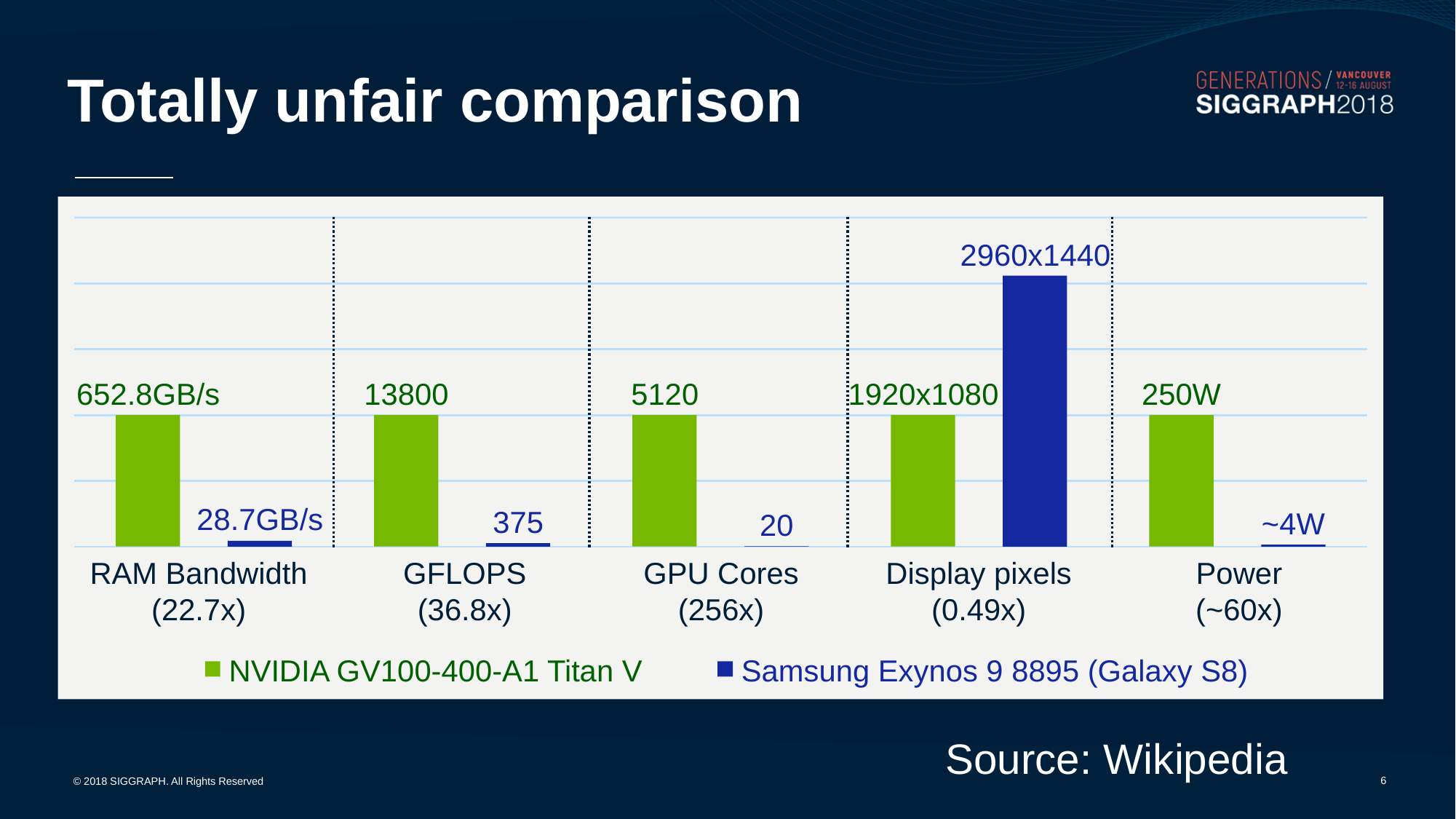
What is the RAM Bandwidth value for the NVIDIA GV100-400-A1 Titan V? 652.8GB/s For Display pixels, which series has the taller bar? Samsung Exynos 9 8895 (Galaxy S8) How many series does the legend list? 2 What is the difference in GPU Cores between the NVIDIA GV100-400-A1 Titan V and the Samsung Exynos 9 8895 (Galaxy S8)? 5100 What is the difference in GFLOPS between the NVIDIA GV100-400-A1 Titan V and the Samsung Exynos 9 8895 (Galaxy S8)? 13425 What is the Power value for the NVIDIA GV100-400-A1 Titan V? 250W How many GPU Cores does the Samsung Exynos 9 8895 (Galaxy S8) have according to the chart? 20 What is the RAM Bandwidth value for the Samsung Exynos 9 8895 (Galaxy S8)? 28.7GB/s What GFLOPS value is shown for the NVIDIA GV100-400-A1 Titan V? 13800 What kind of chart is shown on the slide? Bar chart What Display pixels value is shown for the Samsung Exynos 9 8895 (Galaxy S8)? 2960x1440 How many categories are shown on the x axis of the chart? 5